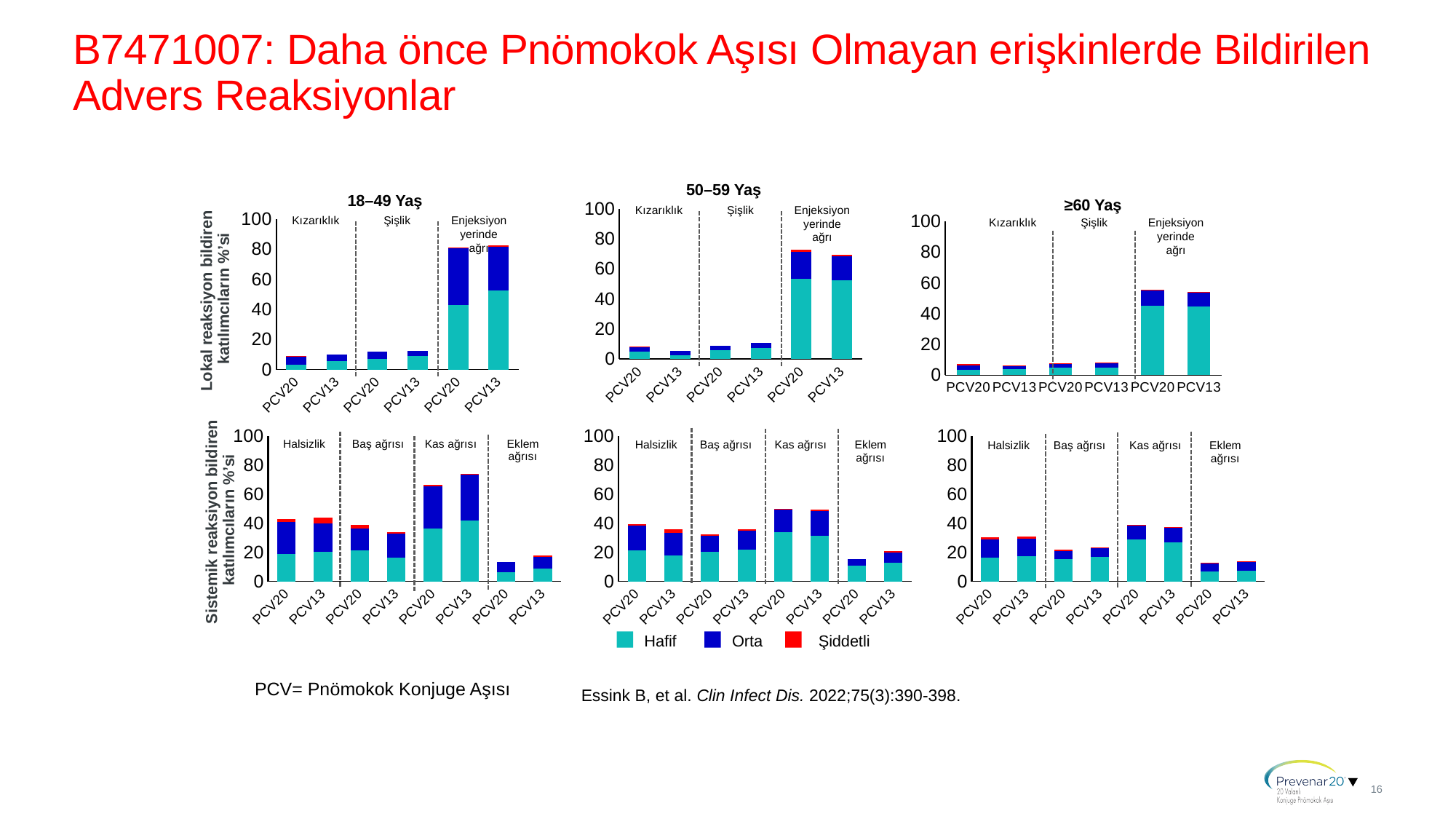
In the 50–59 Yaş systemic reactions (bottom-middle) chart, is the total value for PCV20 under Halsizlik greater or less than 20? greater How many bars are plotted in the ≥60 Yaş systemic reactions (bottom-right) chart? 8 In the 18–49 Yaş systemic reactions (bottom-left) chart, which bar is taller under Kas ağrısı, PCV20 or PCV13? PCV13 In the 18–49 Yaş systemic reactions (bottom-left) chart, which bar is the lowest overall? PCV20 under Eklem ağrısı In the ≥60 Yaş local reactions (top-right) chart, is the total value for PCV20 under Enjeksiyon yerinde ağrı greater or less than 40? greater In the 18–49 Yaş local reactions (top-left) chart, is the total value for PCV20 under Enjeksiyon yerinde ağrı greater or less than 60? greater How many series does the shared legend at the bottom of the slide list? 3 What kind of chart is used for the 18–49 Yaş local reactions (top-left) chart? Stacked bar chart What are the three legend entries shown below the charts? Hafif, Orta, Şiddetli In the ≥60 Yaş local reactions (top-right) chart, which reaction category has the tallest bars? Enjeksiyon yerinde ağrı In the 50–59 Yaş systemic reactions (bottom-middle) chart, which bar is taller under Eklem ağrısı, PCV20 or PCV13? PCV13